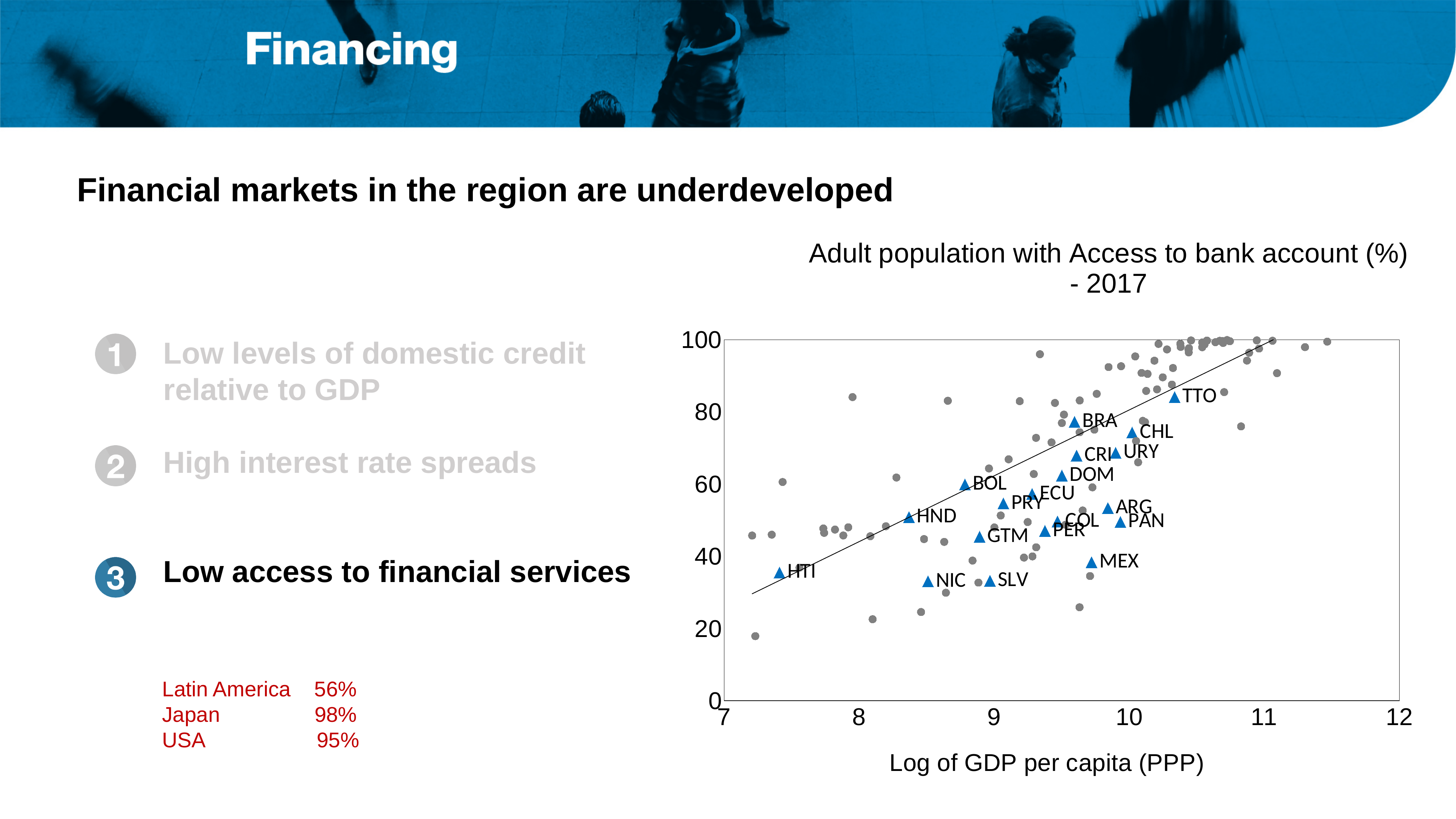
How many countries are labeled with triangle markers on the chart? 19 What kind of chart is shown on the slide? scatter chart Is the value for TTO greater or less than 80? greater Among the labeled (triangle) countries, which has the highest share of adults with access to a bank account? TTO Is the value for NIC greater or less than 40? less Which has a higher share of adults with a bank account, BRA or MEX? BRA Is the value for HTI greater or less than 40? less Do the values generally rise or fall as log of GDP per capita increases along the x axis? rise What is the title of the chart? Adult population with Access to bank account (%) - 2017 What is the label of the x axis of the chart? Log of GDP per capita (PPP)